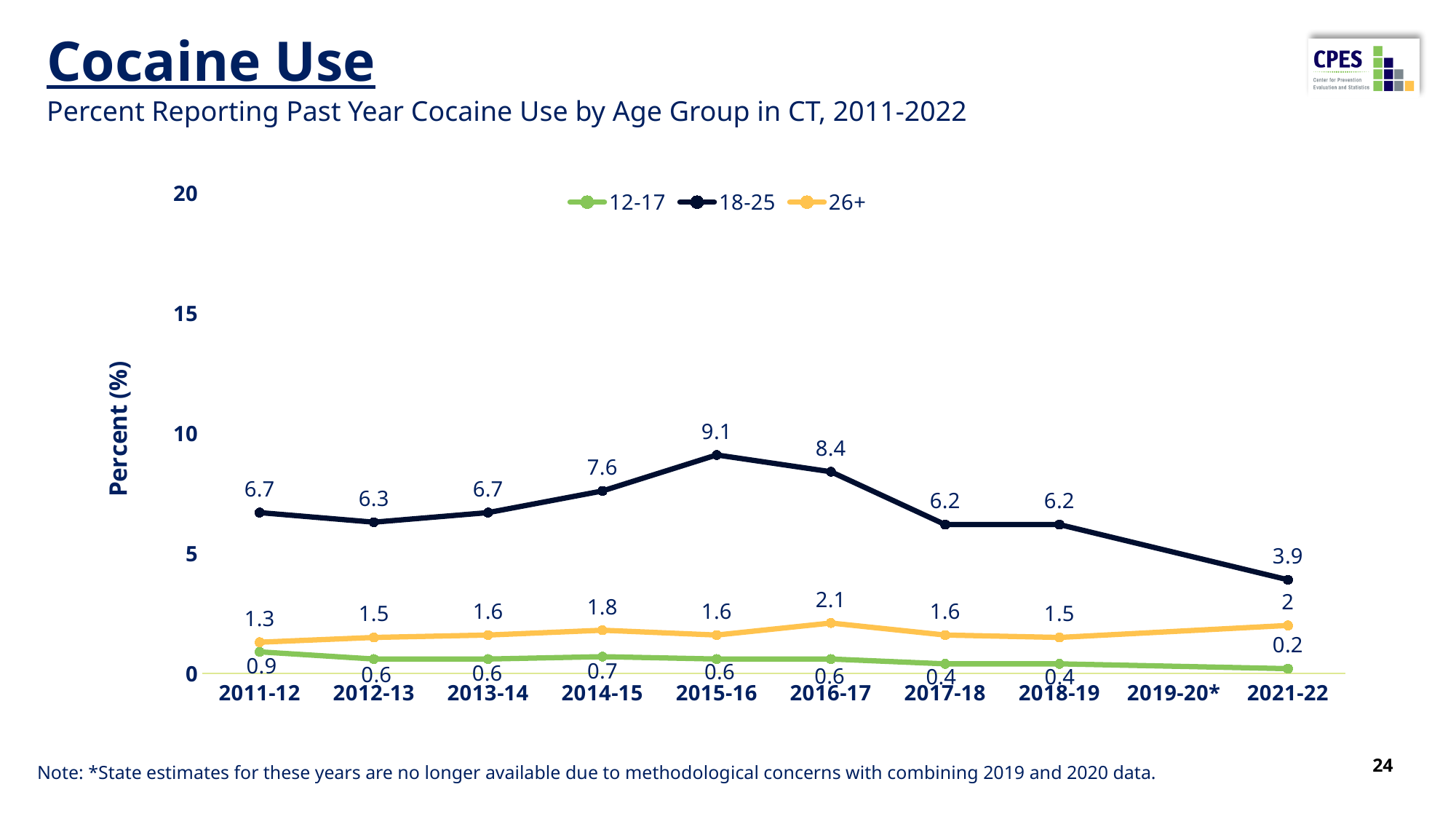
For the 26+ age group, which year had the larger value: 2014-15 or 2016-17? 2016-17 What is the value for the 26+ age group in 2016-17? 2.1 Is the value for the 18-25 age group in 2015-16 greater or less than 10? less How much did the 18-25 value fall from 2015-16 to 2021-22? 5.2 In which year did the 18-25 age group have its lowest value? 2021-22 What kind of chart is shown on the slide? line chart What is the value for the 12-17 age group in 2011-12? 0.9 What is the label on the vertical axis of the chart? Percent (%) Did the 18-25 age group's values rise or fall from 2016-17 to 2021-22? fall What percent of the 18-25 age group reported past year cocaine use in 2015-16? 9.1 In which year did the 18-25 age group reach its highest value? 2015-16 How many age groups does the legend list? 3